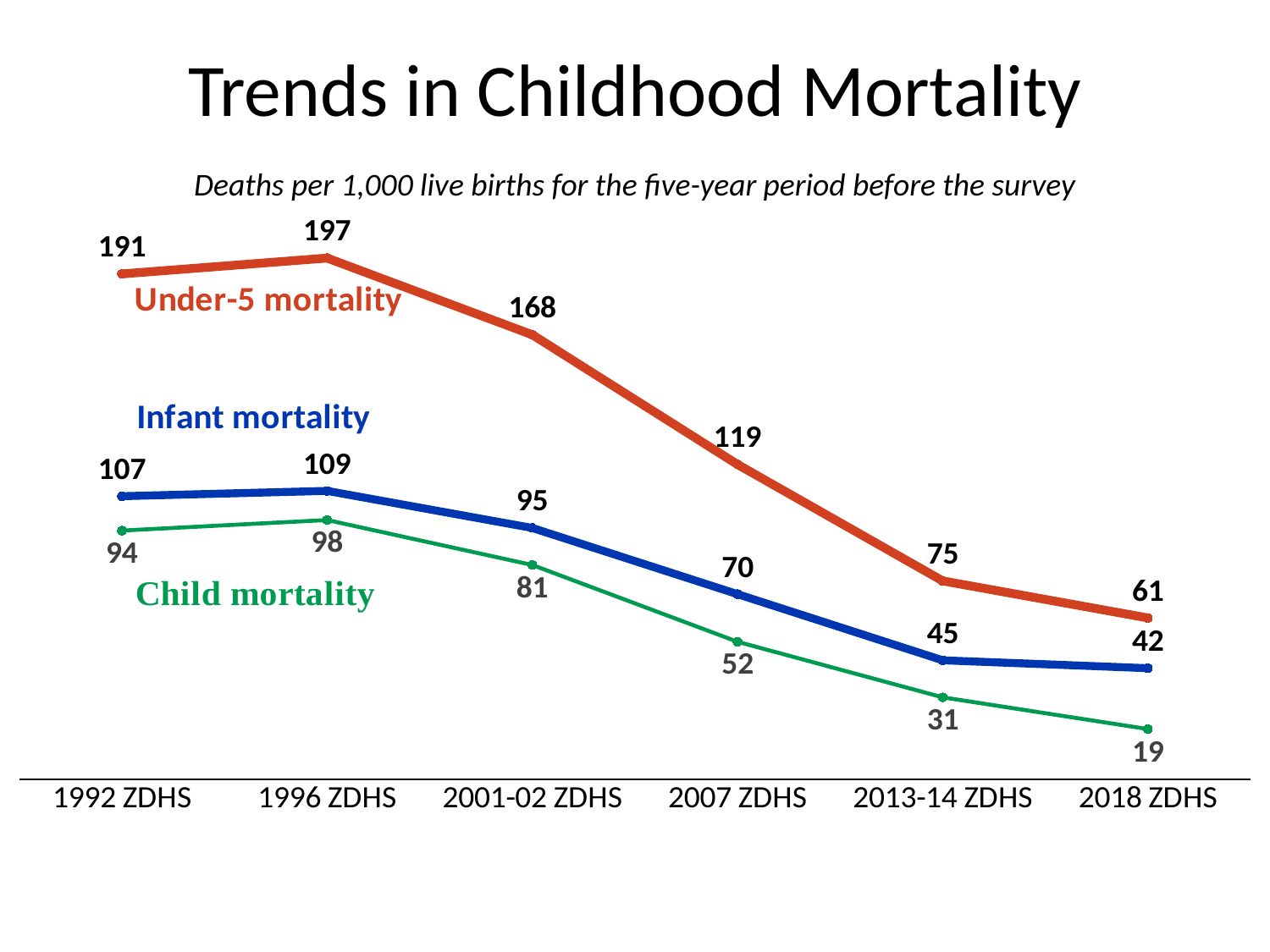
What kind of chart is shown on the slide? Line chart In which survey is under-5 mortality highest? 1996 ZDHS What is the difference between infant mortality and child mortality in 2013-14 ZDHS? 14 Does infant mortality rise or fall from 1996 ZDHS to 2018 ZDHS? Fall What is the infant mortality value for 2007 ZDHS? 70 Which is larger: infant mortality in 1996 ZDHS or under-5 mortality in 2007 ZDHS? Under-5 mortality in 2007 ZDHS What is the under-5 mortality value for 2018 ZDHS? 61 In which survey is child mortality lowest? 2018 ZDHS How many survey points are shown on the x axis? 6 How many series are plotted on the chart? 3 What is the difference between under-5 mortality in 1992 ZDHS and 2018 ZDHS? 130 What is the child mortality value for 2001-02 ZDHS? 81